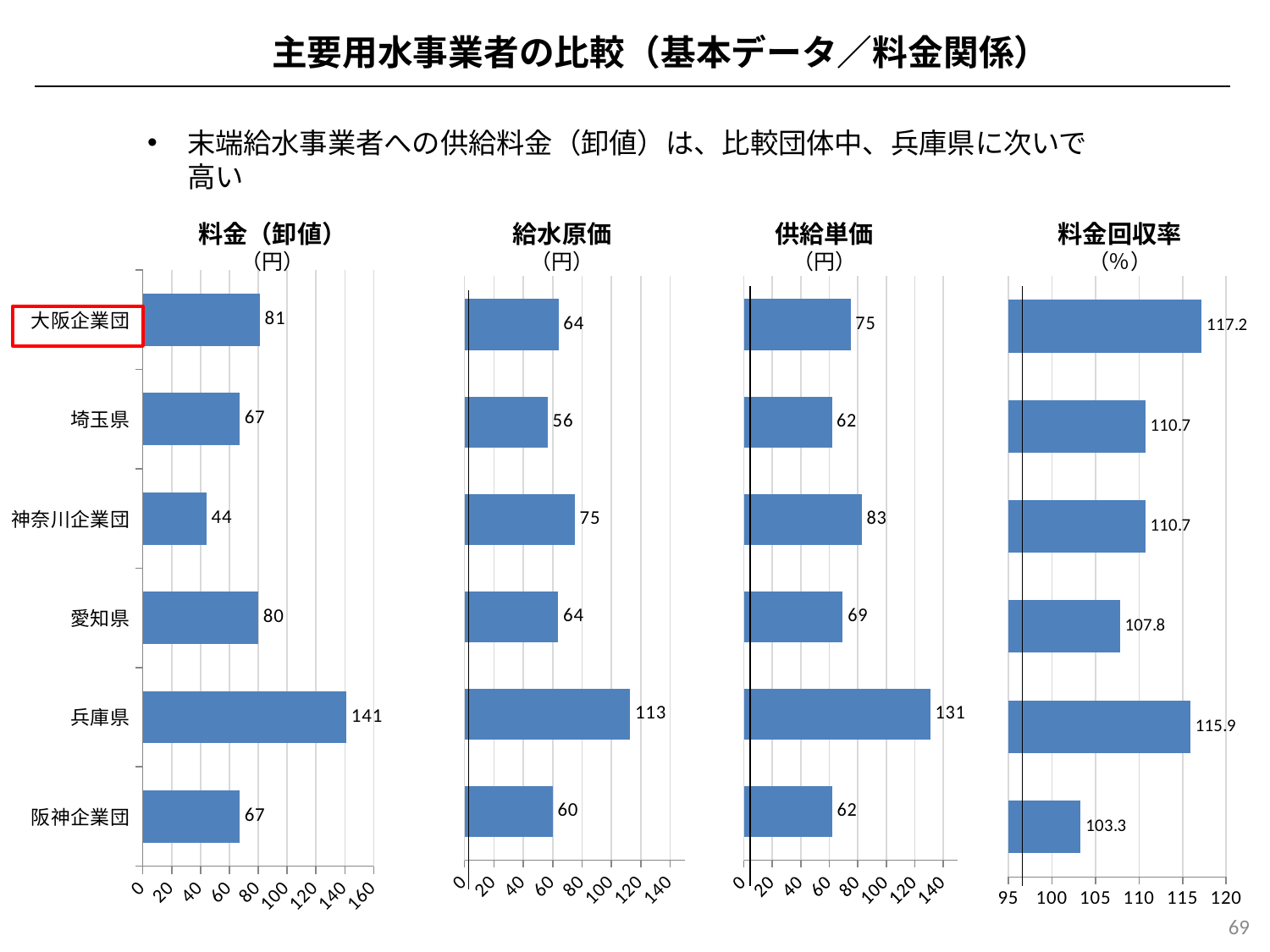
In the 料金（卸値） chart, which category has the highest value? 兵庫県 In the 料金回収率 chart, which category has the highest value? 大阪企業団 In the 料金（卸値） chart, what is the value for 大阪企業団? 81 What type of chart is the 供給単価 chart? bar chart In the 給水原価 chart, what is the difference between 兵庫県 and 埼玉県? 57 In the 料金回収率 chart, what is the difference between 大阪企業団 and 兵庫県? 1.3 How many categories are shown in the 料金（卸値） chart? 6 In the 料金回収率 chart, what is the value for 阪神企業団? 103.3 In the 給水原価 chart, what is the value for 神奈川企業団? 75 In the 供給単価 chart, which is larger, the value for 神奈川企業団 or the value for 愛知県? 神奈川企業団 In the 供給単価 chart, what is the value for 兵庫県? 131 In the 料金（卸値） chart, which category has the lowest value? 神奈川企業団